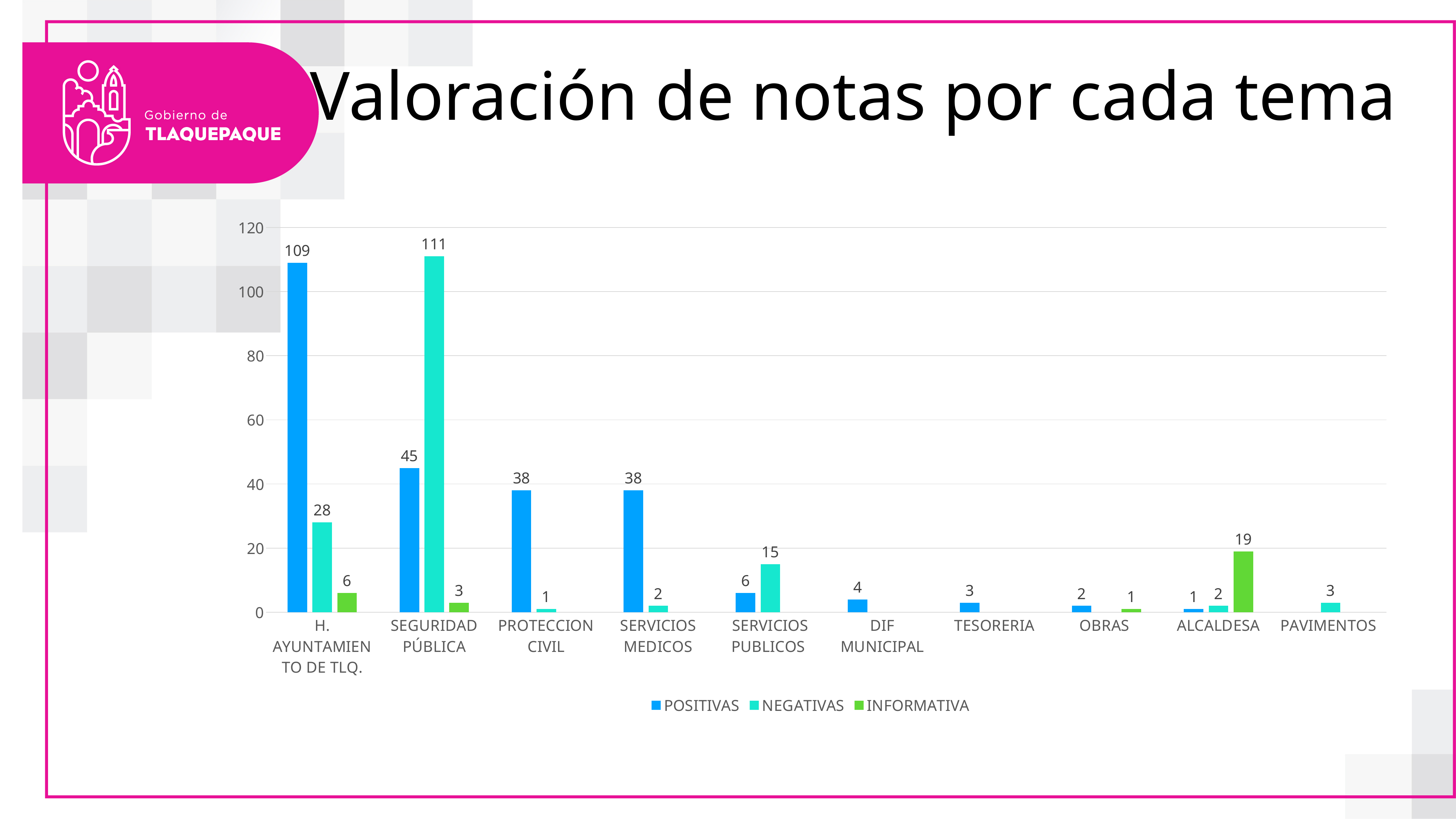
What is the NEGATIVAS value for SEGURIDAD PÚBLICA? 111 How many categories are shown on the x axis? 10 What is the title of the chart on the slide? Valoración de notas por cada tema What is the difference between the NEGATIVAS and POSITIVAS values for SEGURIDAD PÚBLICA? 66 How many series does the legend list? 3 What is the NEGATIVAS value for SERVICIOS PUBLICOS? 15 What is the POSITIVAS value for H. AYUNTAMIENTO DE TLQ.? 109 Which is larger for H. AYUNTAMIENTO DE TLQ., the POSITIVAS value or the NEGATIVAS value? POSITIVAS What kind of chart is shown on the slide? Bar chart Which category has the highest NEGATIVAS value? SEGURIDAD PÚBLICA Which category has the highest POSITIVAS value? H. AYUNTAMIENTO DE TLQ. What is the INFORMATIVA value for ALCALDESA? 19